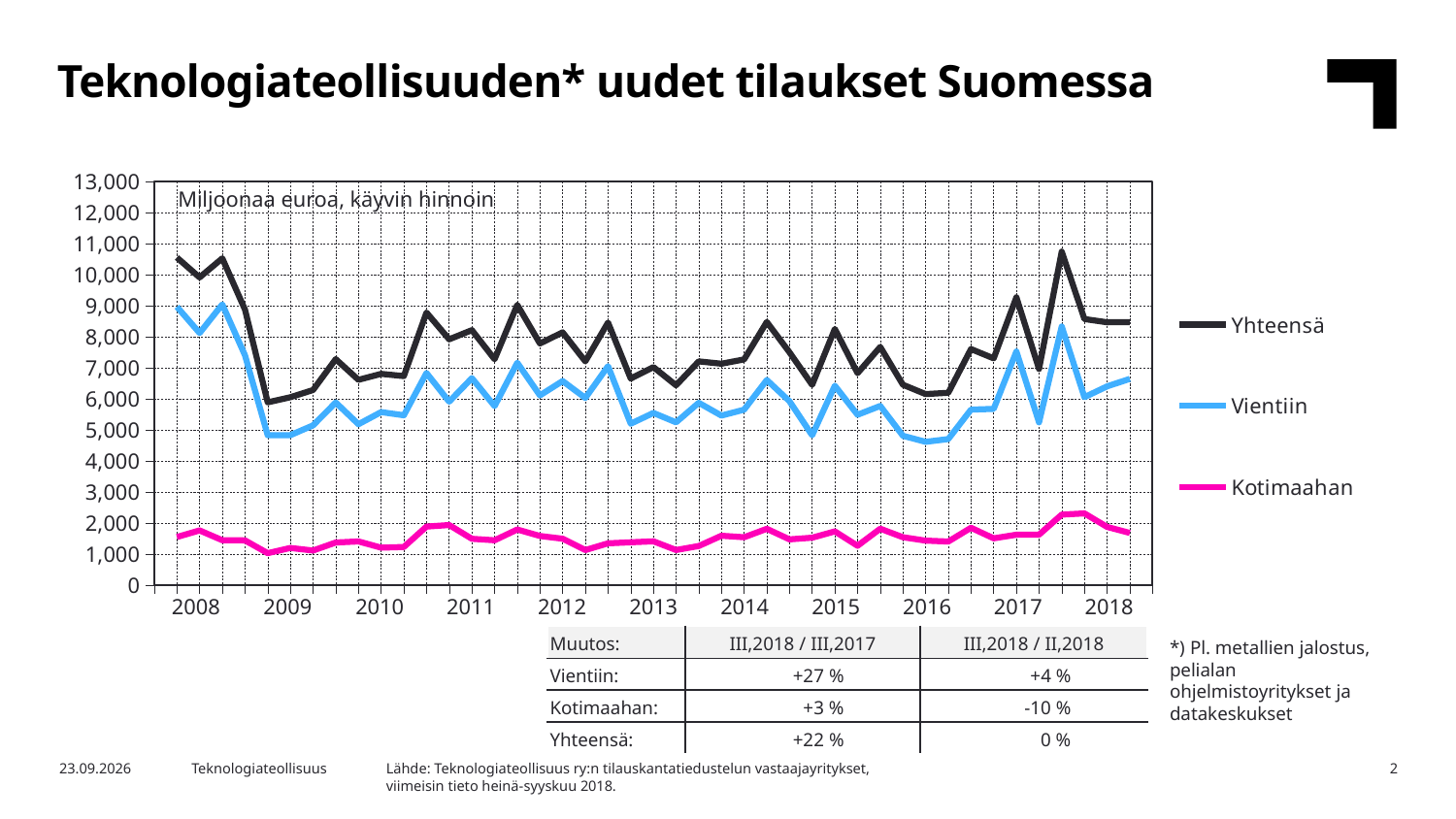
Is the value for Vientiin at the start of 2009 greater or less than 6,000? less Which series has the highest values across the whole chart? Yhteensä Does the Yhteensä line rise or fall from 2008 to the start of 2009? fall How many series does the chart legend list? 3 Which series has the lowest values across the whole chart? Kotimaahan Is the value for Yhteensä at the start of 2008 greater or less than 10,000? greater What unit label is printed inside the chart area? Miljoonaa euroa, käyvin hinnoin Is the value for Kotimaahan at the start of 2008 greater or less than 3,000? less What is the highest value shown on the vertical axis? 13,000 At the end of 2018, which is larger, Yhteensä or Vientiin? Yhteensä What are the three series listed in the chart legend? Yhteensä, Vientiin, Kotimaahan What kind of chart is shown on the slide? line chart